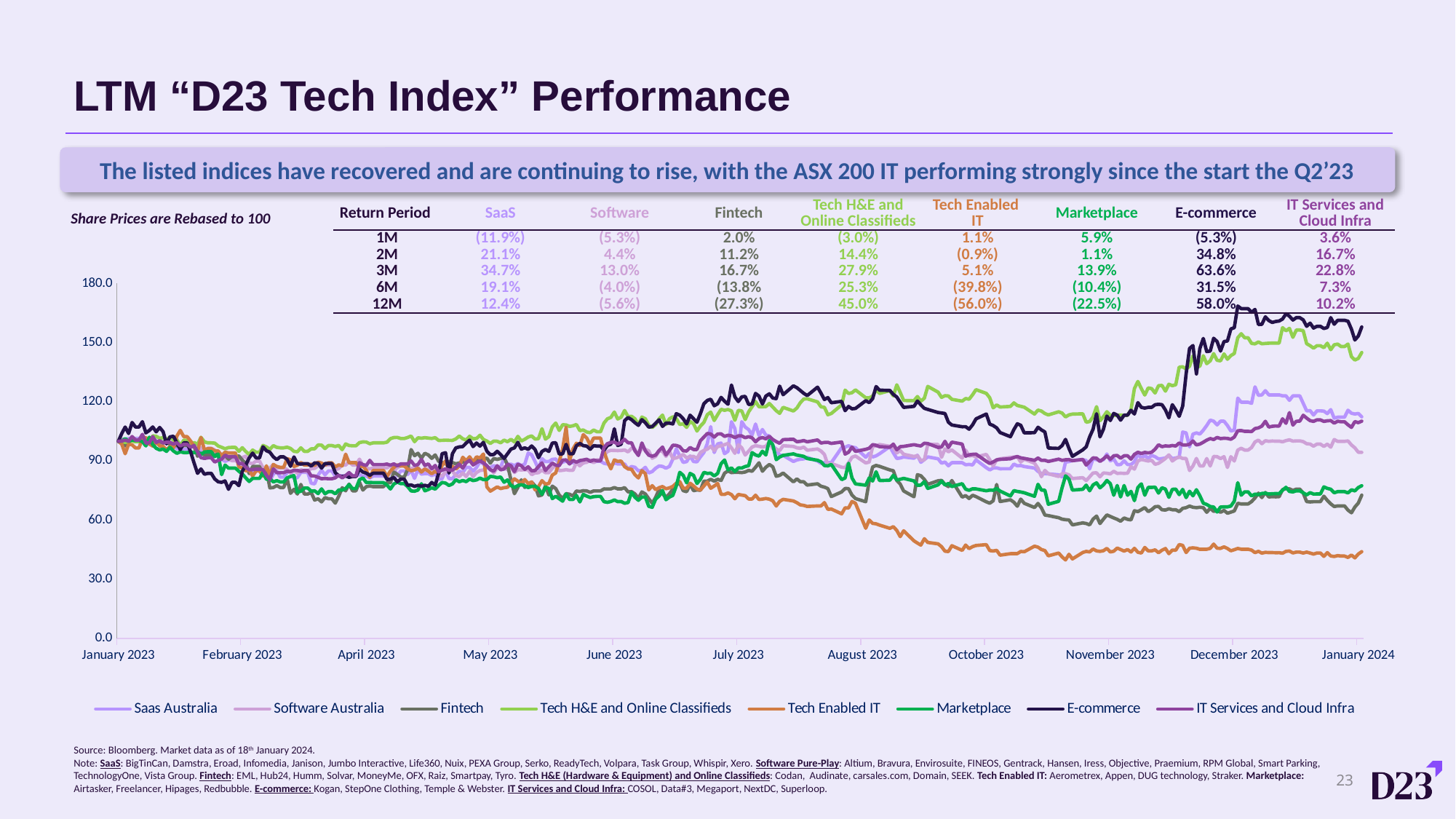
Which series is highest at the right-hand end of the chart (January 2024)? E-commerce Is the value for E-commerce at January 2024 greater or less than 120? greater What is the highest value shown on the chart's vertical axis? 180.0 Which series is lowest at the right-hand end of the chart (January 2024)? Tech Enabled IT According to the table above the chart, what is the 3M return for SaaS? 34.7% What kind of chart is shown on the slide? line chart Is the value for Tech Enabled IT at January 2024 greater or less than 60? less According to the table above the chart, what is the 12M return for E-commerce? 58.0% At January 2024, which is larger: E-commerce or Tech Enabled IT? E-commerce Does the Tech Enabled IT line rise or fall overall from January 2023 to January 2024? fall How many series does the chart's legend list? 8 Is the value for Fintech at January 2024 greater or less than 90? less